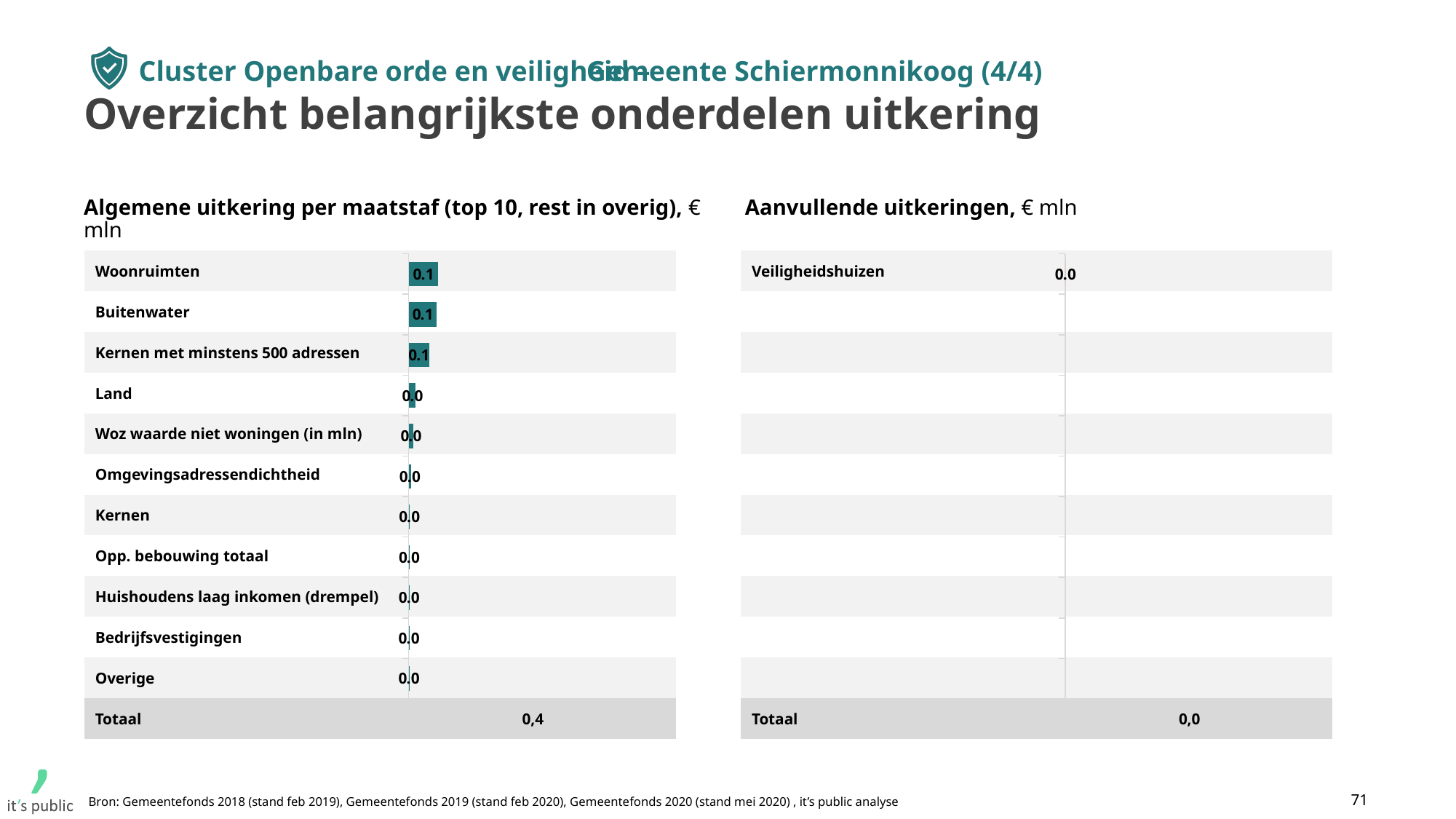
In the chart 'Algemene uitkering per maatstaf', what is the value for Buitenwater? 0.1 What unit is stated in the title of the chart 'Aanvullende uitkeringen'? € mln In the chart 'Algemene uitkering per maatstaf', what is the value for Land? 0.0 In the chart 'Aanvullende uitkeringen', what is the value for Veiligheidshuizen? 0.0 In the chart 'Algemene uitkering per maatstaf', which is larger: Woonruimten or Land? Woonruimten In the chart 'Algemene uitkering per maatstaf', what is the Totaal shown at the bottom? 0,4 In the chart 'Algemene uitkering per maatstaf', what is the value for Kernen met minstens 500 adressen? 0.1 In the chart 'Algemene uitkering per maatstaf', what is the value for Woonruimten? 0.1 In the chart 'Aanvullende uitkeringen', what is the Totaal shown at the bottom? 0,0 How many categories (excluding Totaal) are shown in the chart 'Algemene uitkering per maatstaf'? 11 In the chart 'Algemene uitkering per maatstaf', what is the difference between Buitenwater and Overige? 0.1 What kind of chart is 'Algemene uitkering per maatstaf'? Bar chart